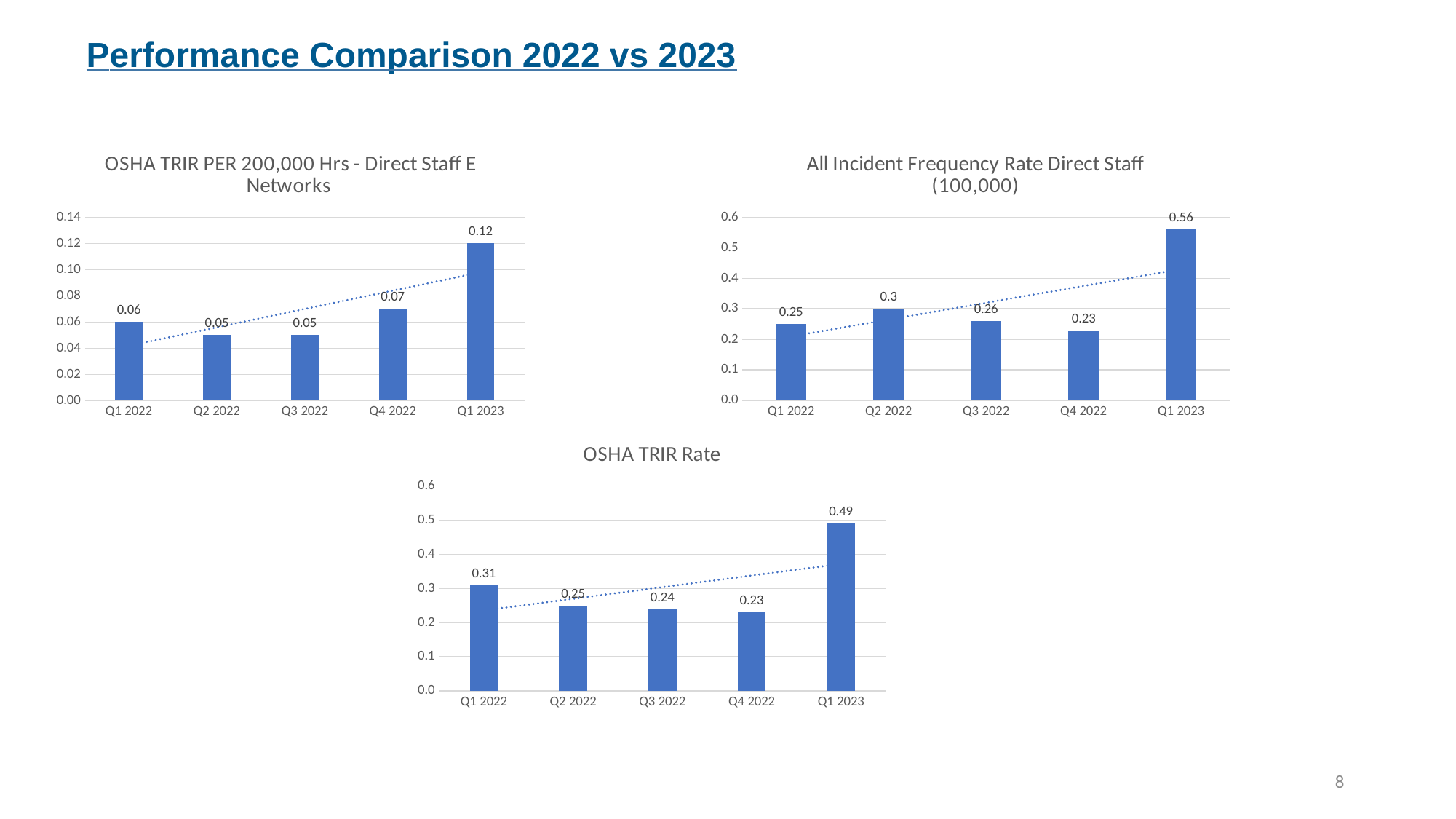
What kind of chart is the 'OSHA TRIR Rate' chart? Bar chart In the 'OSHA TRIR PER 200,000 Hrs - Direct Staff E Networks' chart, what is the value for Q1 2023? 0.12 In the 'OSHA TRIR Rate' chart, what is the value for Q1 2022? 0.31 In the 'OSHA TRIR PER 200,000 Hrs - Direct Staff E Networks' chart, what is the difference between Q1 2023 and Q4 2022? 0.05 In the 'All Incident Frequency Rate Direct Staff (100,000)' chart, what is the value for Q2 2022? 0.3 How many charts are shown on the slide? 3 In the 'All Incident Frequency Rate Direct Staff (100,000)' chart, which quarter has the lowest value? Q4 2022 In the 'OSHA TRIR Rate' chart, what is the difference between Q1 2023 and Q1 2022? 0.18 In the 'All Incident Frequency Rate Direct Staff (100,000)' chart, is the value for Q1 2023 greater or less than 0.5? greater In the 'All Incident Frequency Rate Direct Staff (100,000)' chart, which is larger, Q1 2022 or Q3 2022? Q3 2022 In the 'OSHA TRIR PER 200,000 Hrs - Direct Staff E Networks' chart, which quarter has the highest value? Q1 2023 In the 'OSHA TRIR Rate' chart, how many quarters are plotted? 5